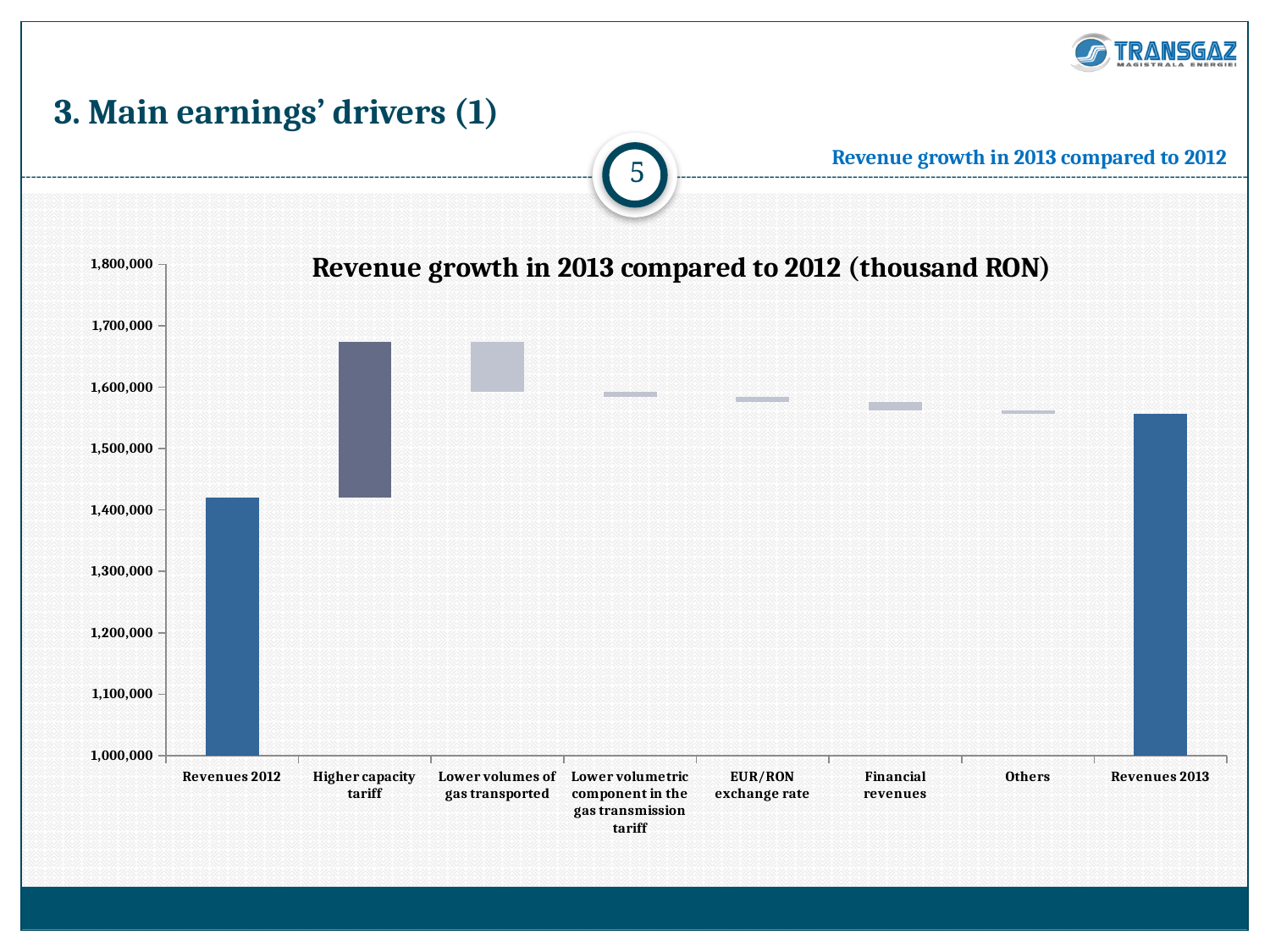
Is the value for Revenues 2012 greater or less than 1,500,000? less What is the lowest value shown on the vertical axis of the chart? 1,000,000 How many categories are shown along the x axis of the chart? 8 Is the value for Revenues 2013 greater or less than 1,500,000? greater In what unit are the values on the chart expressed? thousand RON Which is larger, Revenues 2012 or Revenues 2013? Revenues 2013 Does the top of the Higher capacity tariff bar lie above or below 1,600,000? above What kind of chart is shown on the slide? bar chart What is the title of the chart? Revenue growth in 2013 compared to 2012 (thousand RON)